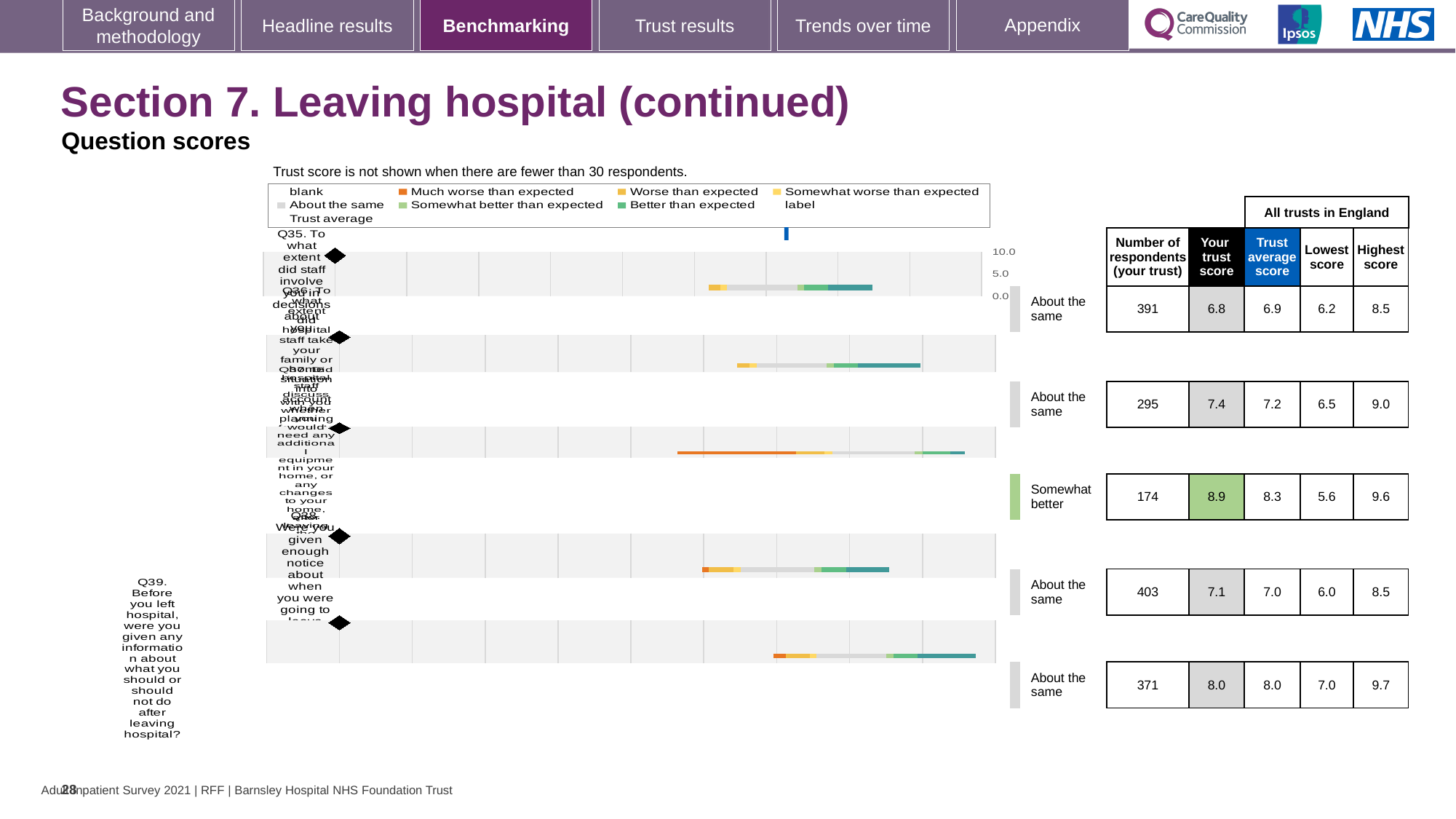
How many questions (rows) are plotted in the benchmarking chart? 5 What kind of chart is used to show the question scores? Bar chart What is the number of respondents for Q39 (the last row of the chart)? 371 What is the difference between the trust score and the trust average score for the third row of the chart? 0.6 What is the trust score for Q35 (the first row of the chart)? 6.8 What is the trust average score for Q38 (were you given enough notice about when you were going to leave hospital)? 7.0 What benchmark category is shown for the third row of the chart? Somewhat better Which row of the chart has the lowest trust score? Q35 (6.8) Is the trust score for Q36 higher or lower than the trust score for Q38? Higher What is the highest score across all trusts in England for the third row of the chart? 9.6 Which row of the chart has the lowest 'Lowest score' value? The third row (5.6) Which row of the chart has the highest trust score? The third row (8.9)